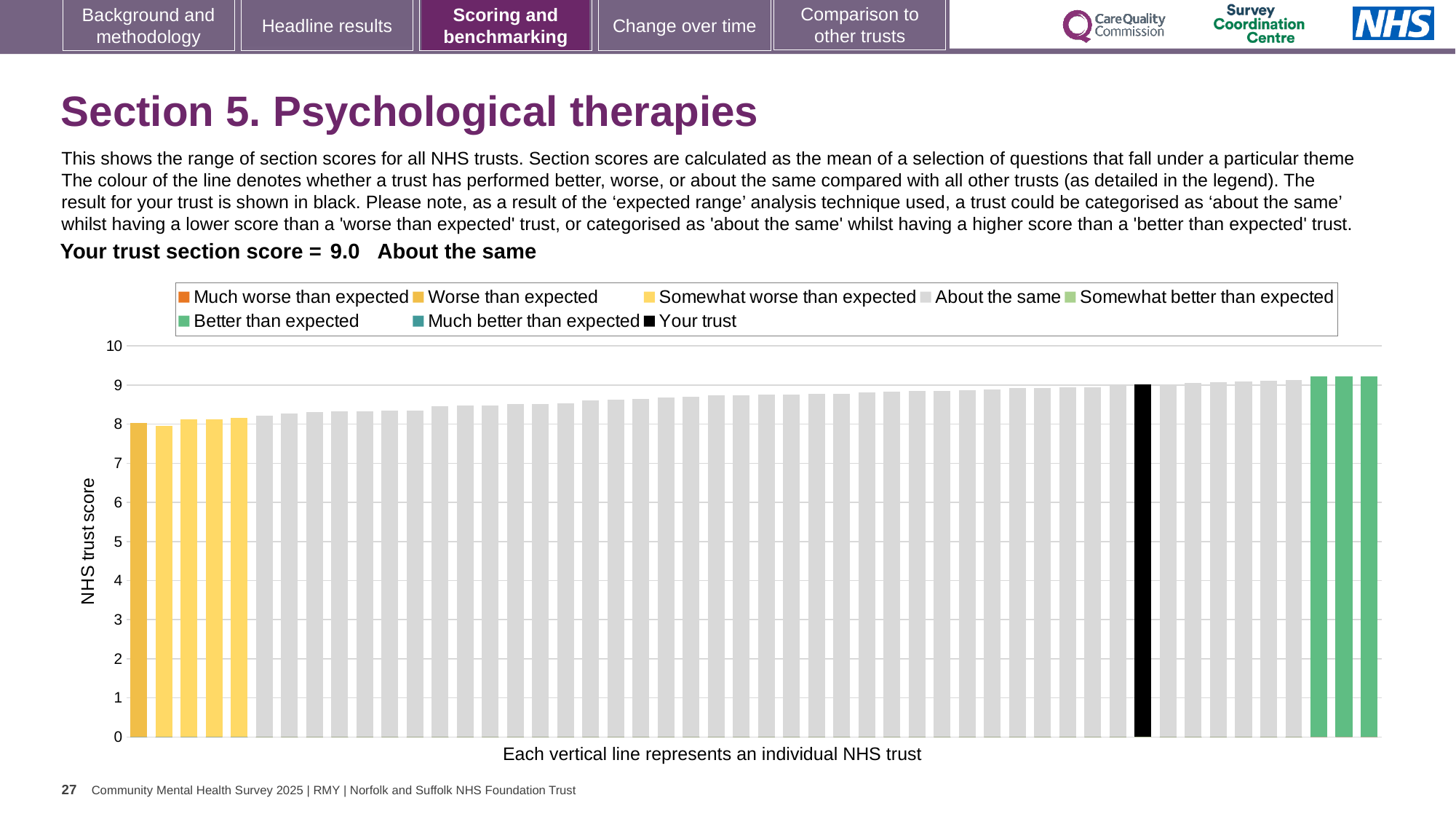
Is the value of the lowest bar on the chart greater or less than 7? greater What colour is the bar representing your trust? Black Do the bar values rise or fall from left to right across the chart? Rise Which performance category is your trust's section score placed in? About the same What is the label on the vertical axis of the chart? NHS trust score Are the green 'Better than expected' bars at the right of the chart greater or less than 9? greater How many entries does the chart legend list? 8 How many green 'Better than expected' bars are shown on the chart? 3 Is the value of the lowest bar on the chart greater or less than 9? less What kind of chart is shown on the slide? Bar chart What is the section score for your trust shown on the slide? 9.0